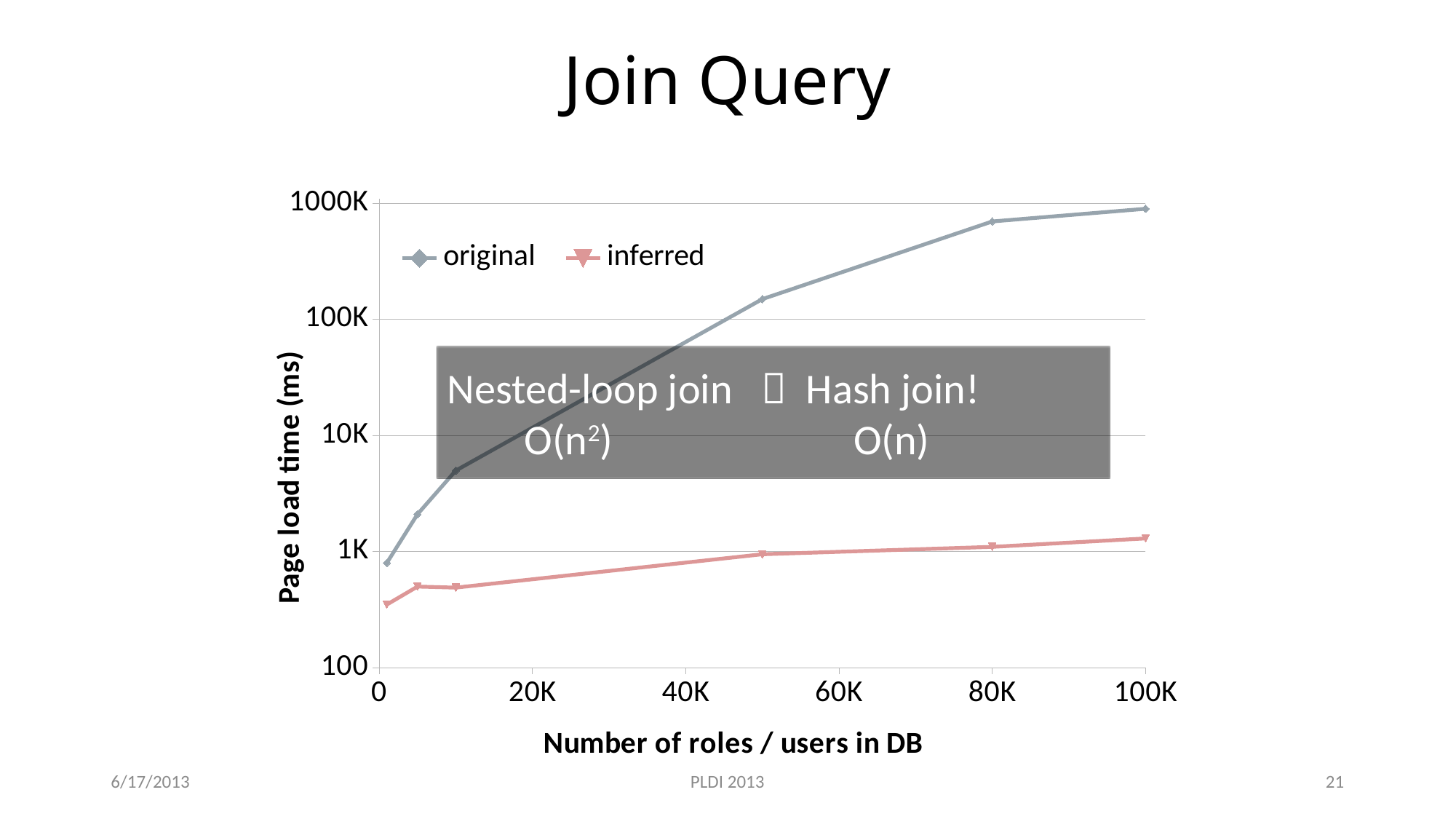
What is the label of the y axis? Page load time (ms) Is the value for the inferred series at 100K greater or less than 1K? greater Is the value for the original series at 100K greater or less than 1000K? less How many series does the legend list? 2 Does the page load time for the original series rise or fall as the number of roles/users increases? rise Is the value for the original series at 100K greater or less than 100K? greater What kind of chart is shown on the slide? line chart Which series has the lower page load time at 80K? inferred Which series has the higher page load time at 100K, original or inferred? original What are the names of the two series in the legend? original and inferred